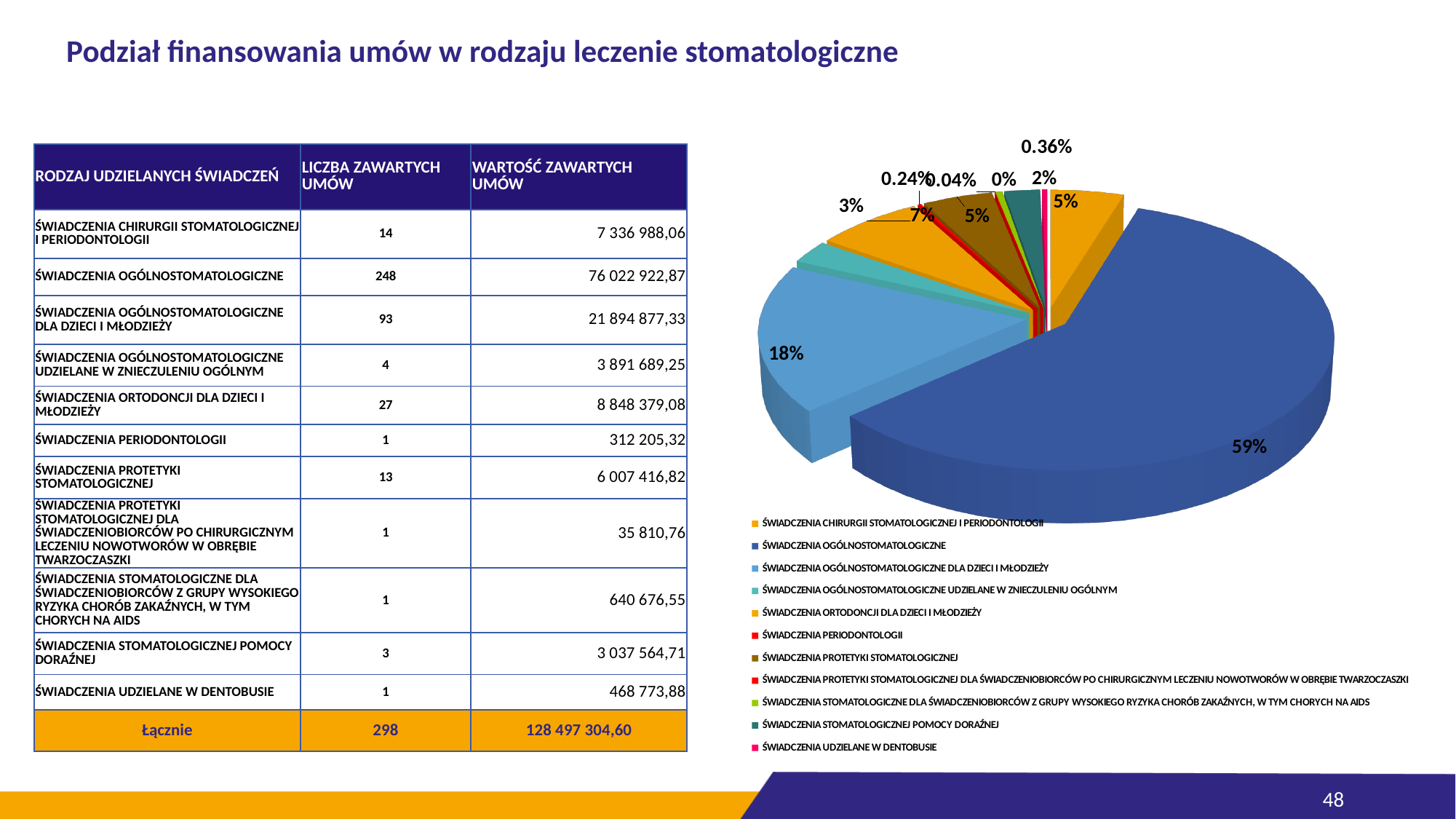
What percentage is shown for ŚWIADCZENIA OGÓLNOSTOMATOLOGICZNE UDZIELANE W ZNIECZULENIU OGÓLNYM? 3% What percentage is shown for ŚWIADCZENIA OGÓLNOSTOMATOLOGICZNE DLA DZIECI I MŁODZIEŻY? 18% What is the difference in percentage points between the share for ŚWIADCZENIA OGÓLNOSTOMATOLOGICZNE and ŚWIADCZENIA OGÓLNOSTOMATOLOGICZNE DLA DZIECI I MŁODZIEŻY? 41 percentage points What is the title of the slide containing the pie chart? Podział finansowania umów w rodzaju leczenie stomatologiczne What colour is the slice for ŚWIADCZENIA OGÓLNOSTOMATOLOGICZNE in the pie chart? dark blue What kind of chart is shown on the slide? pie chart What share of the pie does ŚWIADCZENIA OGÓLNOSTOMATOLOGICZNE have? 59% Which is larger: the share for ŚWIADCZENIA OGÓLNOSTOMATOLOGICZNE DLA DZIECI I MŁODZIEŻY or for ŚWIADCZENIA ORTODONCJI DLA DZIECI I MŁODZIEŻY? ŚWIADCZENIA OGÓLNOSTOMATOLOGICZNE DLA DZIECI I MŁODZIEŻY How many slices does the pie chart have? 11 What percentage is shown for ŚWIADCZENIA ORTODONCJI DLA DZIECI I MŁODZIEŻY? 7% Which category has the largest share of the pie chart? ŚWIADCZENIA OGÓLNOSTOMATOLOGICZNE How many categories does the legend of the pie chart list? 11